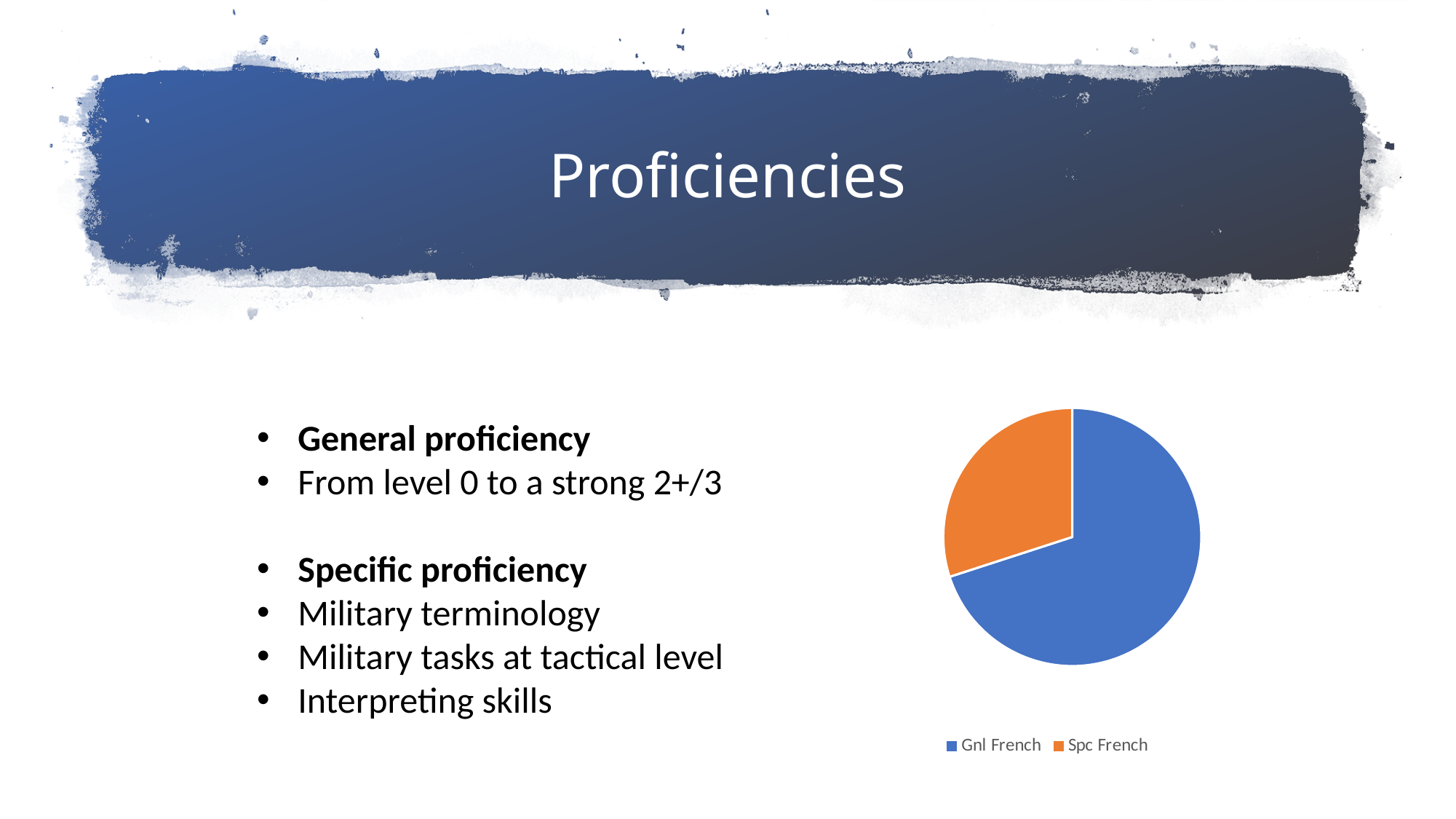
Which slice is larger in the pie chart, Gnl French or Spc French? Gnl French What colour is the Gnl French slice in the pie chart? blue Which slice of the pie chart is the smallest? Spc French How many entries does the pie chart's legend list? 2 What colour is the Spc French slice in the pie chart? orange Which slice of the pie chart is the largest? Gnl French What kind of chart is shown on the slide? pie chart How many slices does the pie chart have? 2